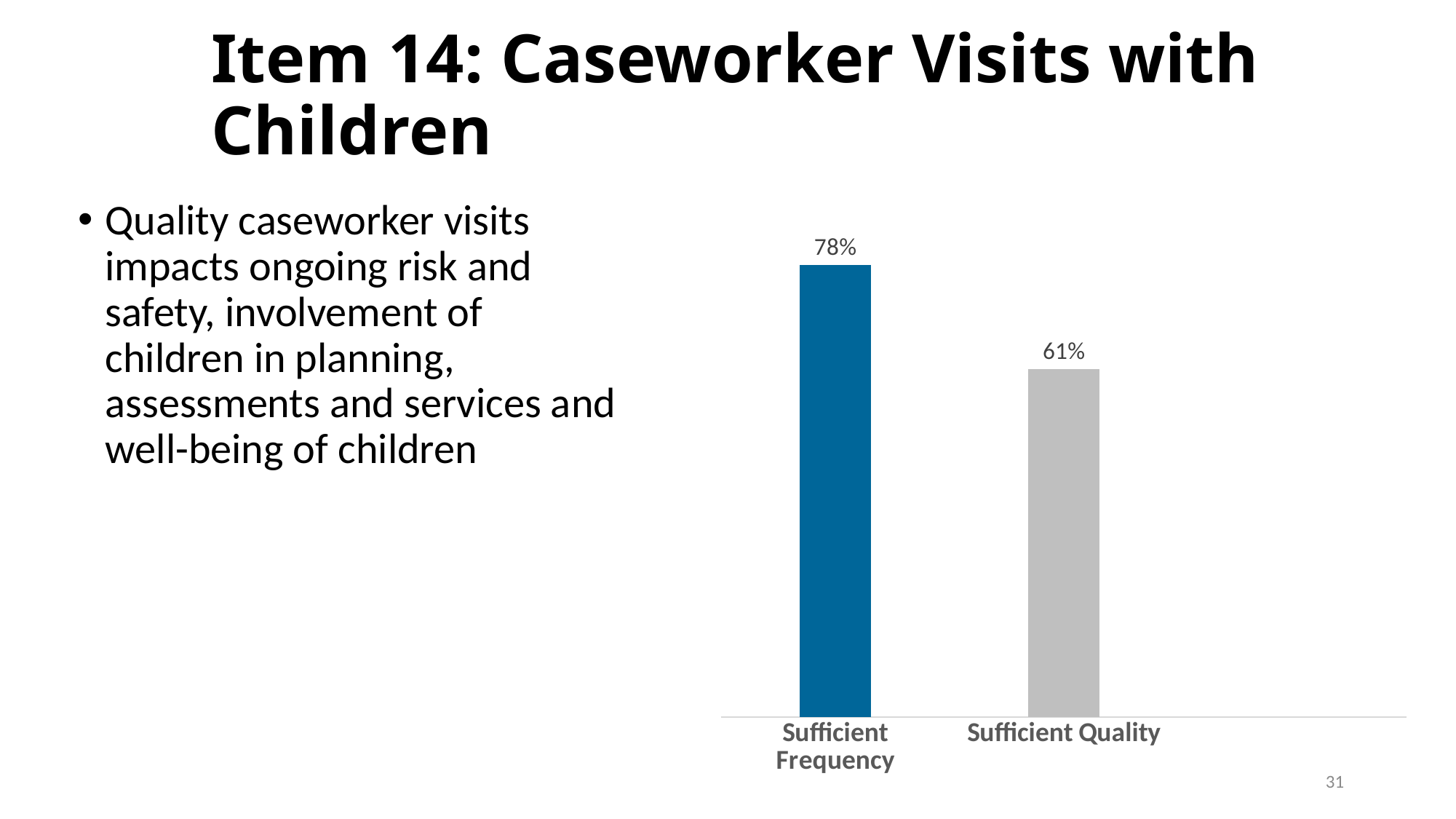
What colour is the bar for Sufficient Frequency? Blue How many categories are shown in the chart? 2 Which category has the lowest value? Sufficient Quality Which is larger, the value for Sufficient Frequency or the value for Sufficient Quality? Sufficient Frequency Which category has the highest value? Sufficient Frequency Do the values rise or fall from left to right across the categories? Fall What kind of chart is shown on the slide? Bar chart What is the difference between the values for Sufficient Frequency and Sufficient Quality? 17% What is the value for Sufficient Frequency? 78% What is the value for Sufficient Quality? 61% What colour is the bar for Sufficient Quality? Grey